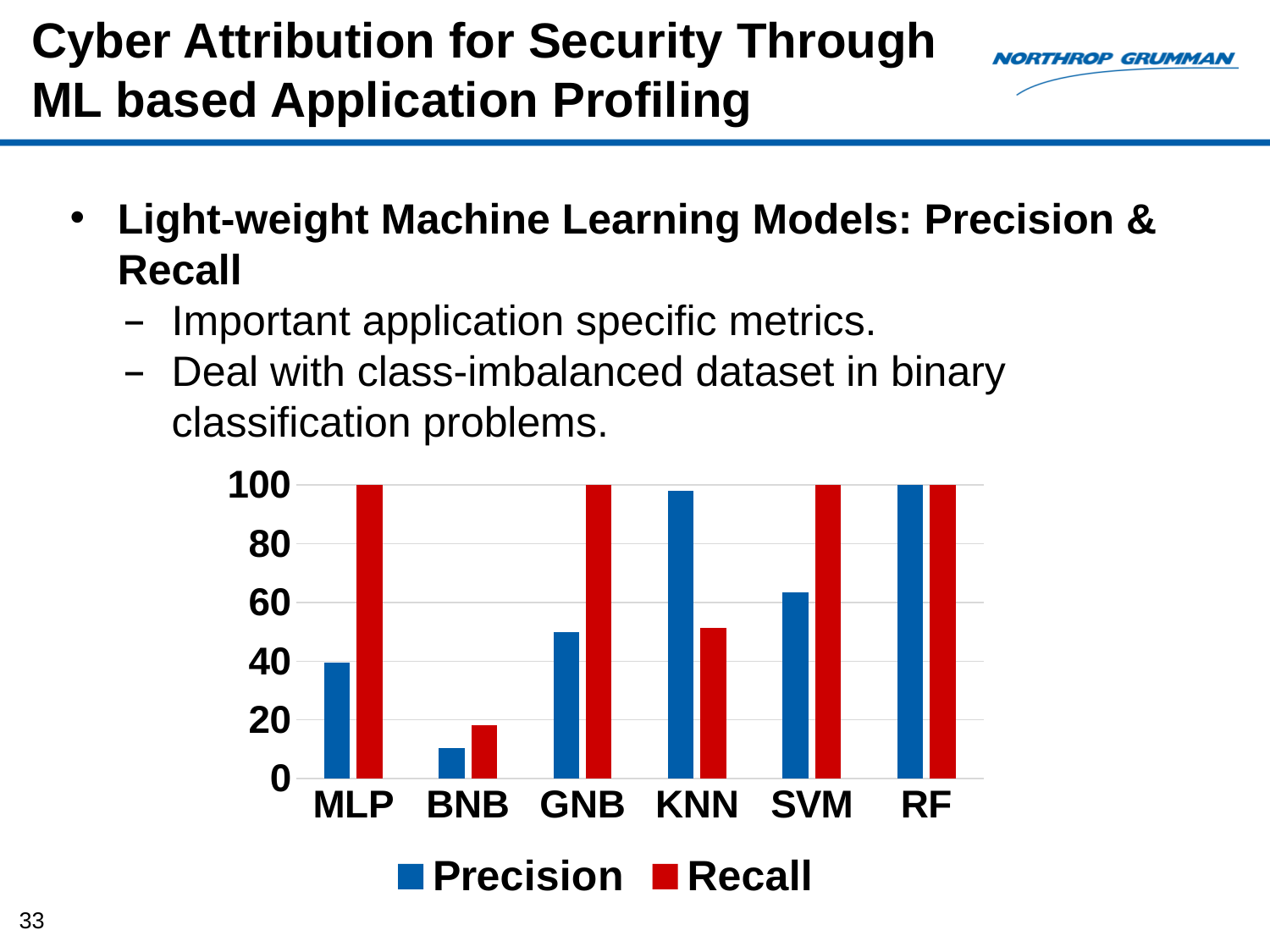
What is the Recall value for MLP? 100 Is the Precision value for GNB greater or less than 60? less Which model has the lowest Precision? BNB How many models (categories) are shown on the x axis of the chart? 6 What kind of chart is shown on the slide? Bar chart How many series does the chart's legend list? 2 Which model has the lowest Recall? BNB For SVM, which is larger: Precision or Recall? Recall What is the Precision value for RF? 100 For KNN, which is larger: Precision or Recall? Precision Is the Precision value for KNN greater or less than 80? greater